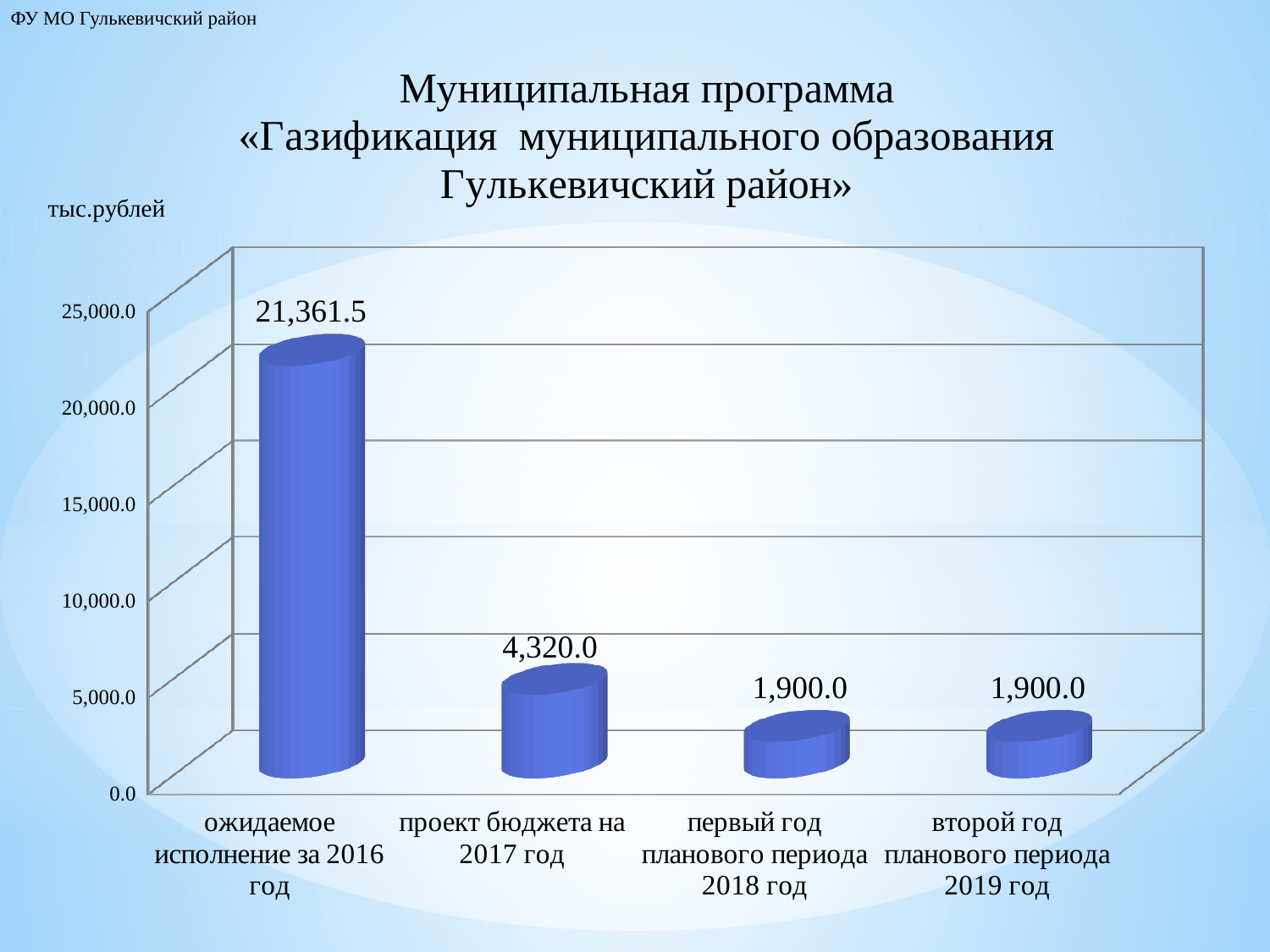
What is the value for «второй год планового периода 2019 год»? 1,900.0 Is the value for «ожидаемое исполнение за 2016 год» greater or less than 20,000.0? greater Which category has the highest value? ожидаемое исполнение за 2016 год Which is larger: the value for «проект бюджета на 2017 год» or for «второй год планового периода 2019 год»? проект бюджета на 2017 год What is the difference between the values for 2016 (ожидаемое исполнение) and 2017 (проект бюджета)? 17,041.5 What is the difference between the values for «проект бюджета на 2017 год» and «первый год планового периода 2018 год»? 2,420.0 What is the value for «проект бюджета на 2017 год»? 4,320.0 How many categories are shown on the x axis? 4 What is the value for «ожидаемое исполнение за 2016 год»? 21,361.5 What unit is indicated above the chart's vertical axis? тыс.рублей What is the value for «первый год планового периода 2018 год»? 1,900.0 What kind of chart is shown on the slide? bar chart